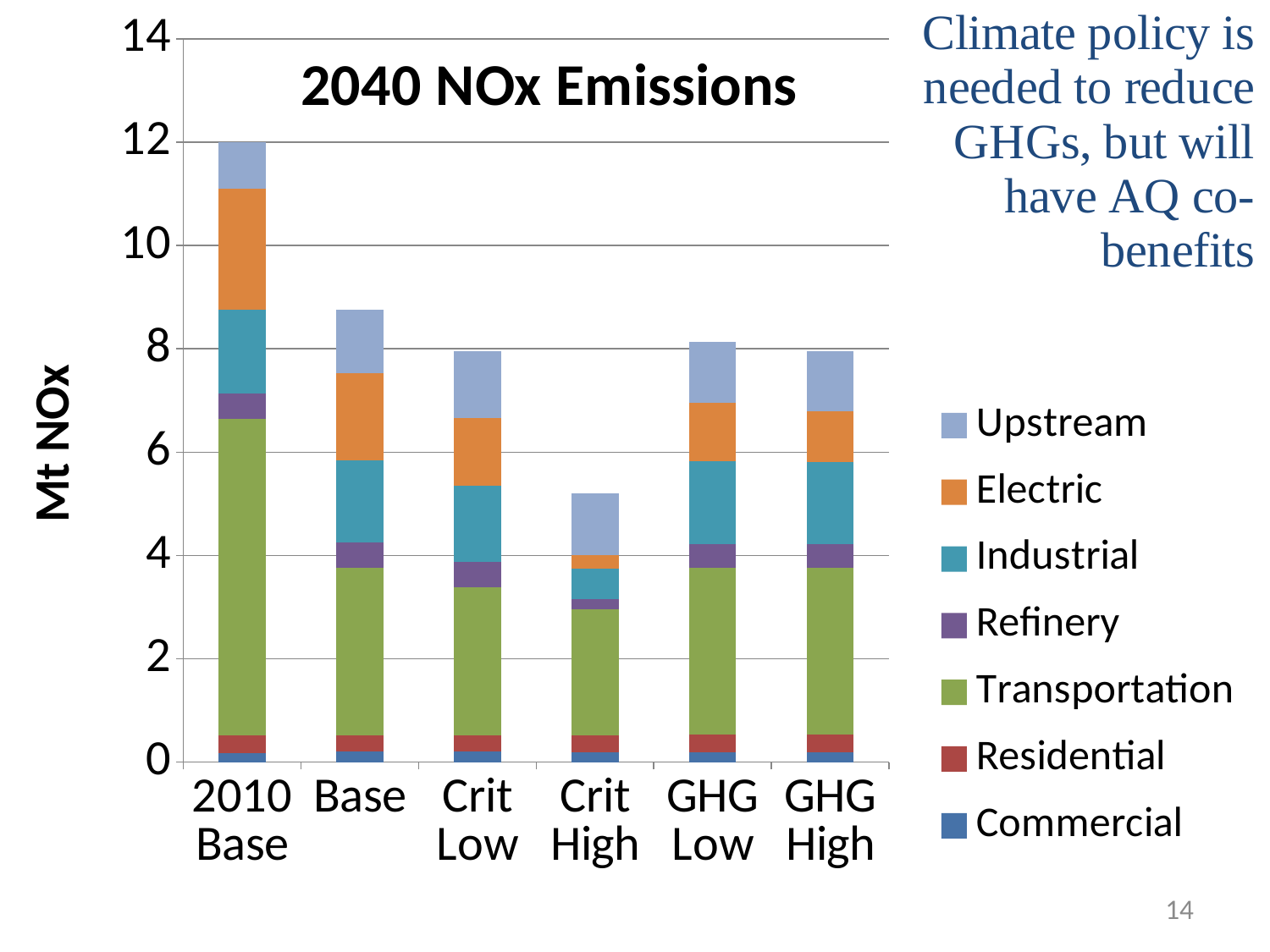
How many series does the legend list? 7 Which has the larger total NOx emissions, Base or Crit High? Base Which has the larger total NOx emissions, Crit High or GHG Low? GHG Low Is the total value for Crit High greater or less than 6? less Which scenario has the highest total NOx emissions? 2010 Base Which scenario has the lowest total NOx emissions? Crit High How many scenario categories are shown along the x axis? 6 What kind of chart is shown on the slide? stacked bar chart What is the title of the chart? 2040 NOx Emissions What is the label on the vertical axis of the chart? Mt NOx Is the total value for 2010 Base greater or less than 10? greater Is the total value for Base greater or less than 8? greater